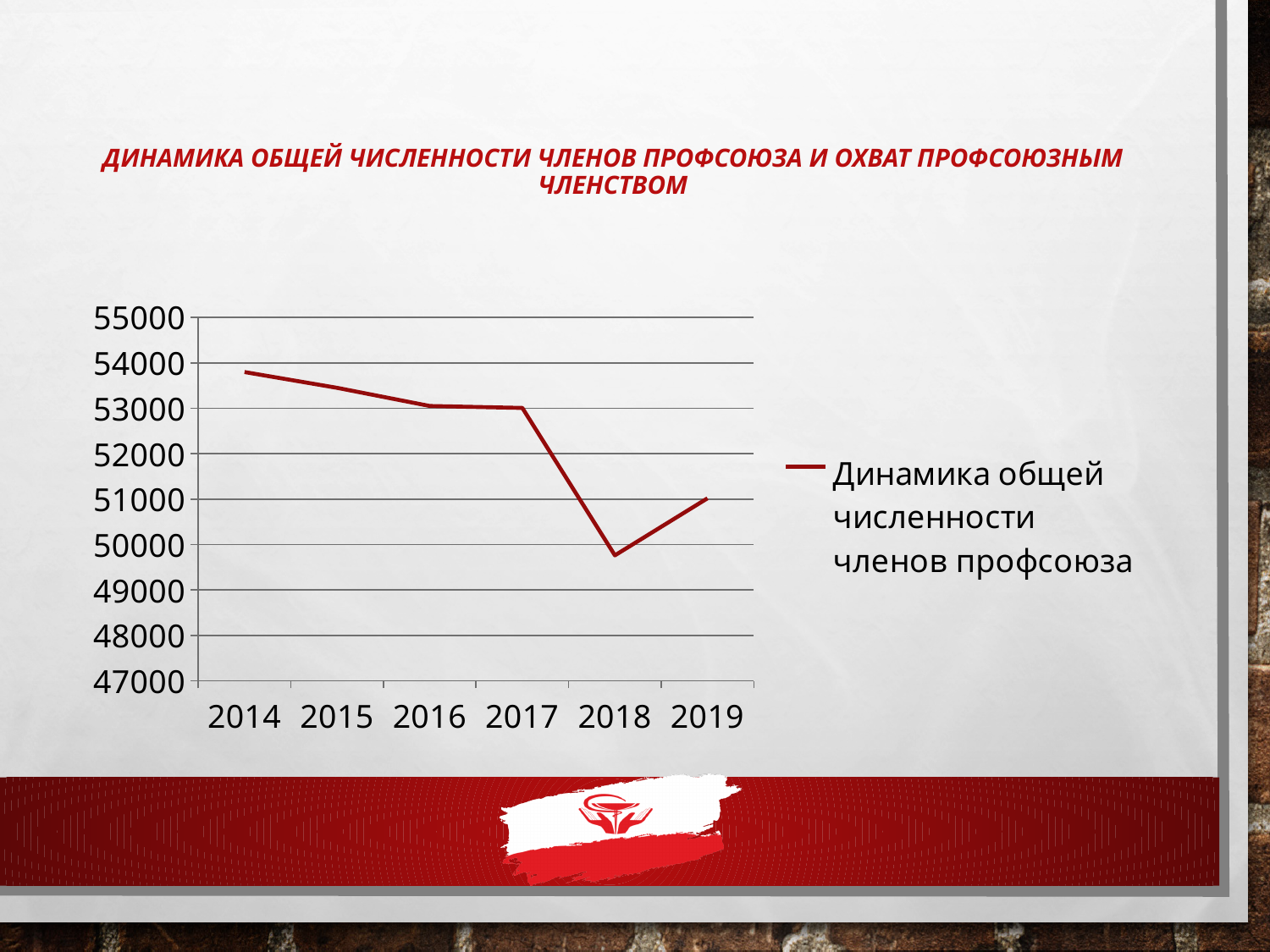
What kind of chart is shown on the slide? line chart How many series does the chart's legend list? 1 What is the name of the series shown in the chart's legend? Динамика общей численности членов профсоюза Which is larger, the value for 2019 or the value for 2018? 2019 Is the value for 2016 greater or less than 52000? greater How many years are plotted on the x axis of the chart? 6 Is the value for 2014 greater or less than 53000? greater Do the values rise or fall from 2014 to 2018? fall Is the value for 2015 greater or less than 54000? less Which year has the highest value on the chart? 2014 Which year has the lowest value on the chart? 2018